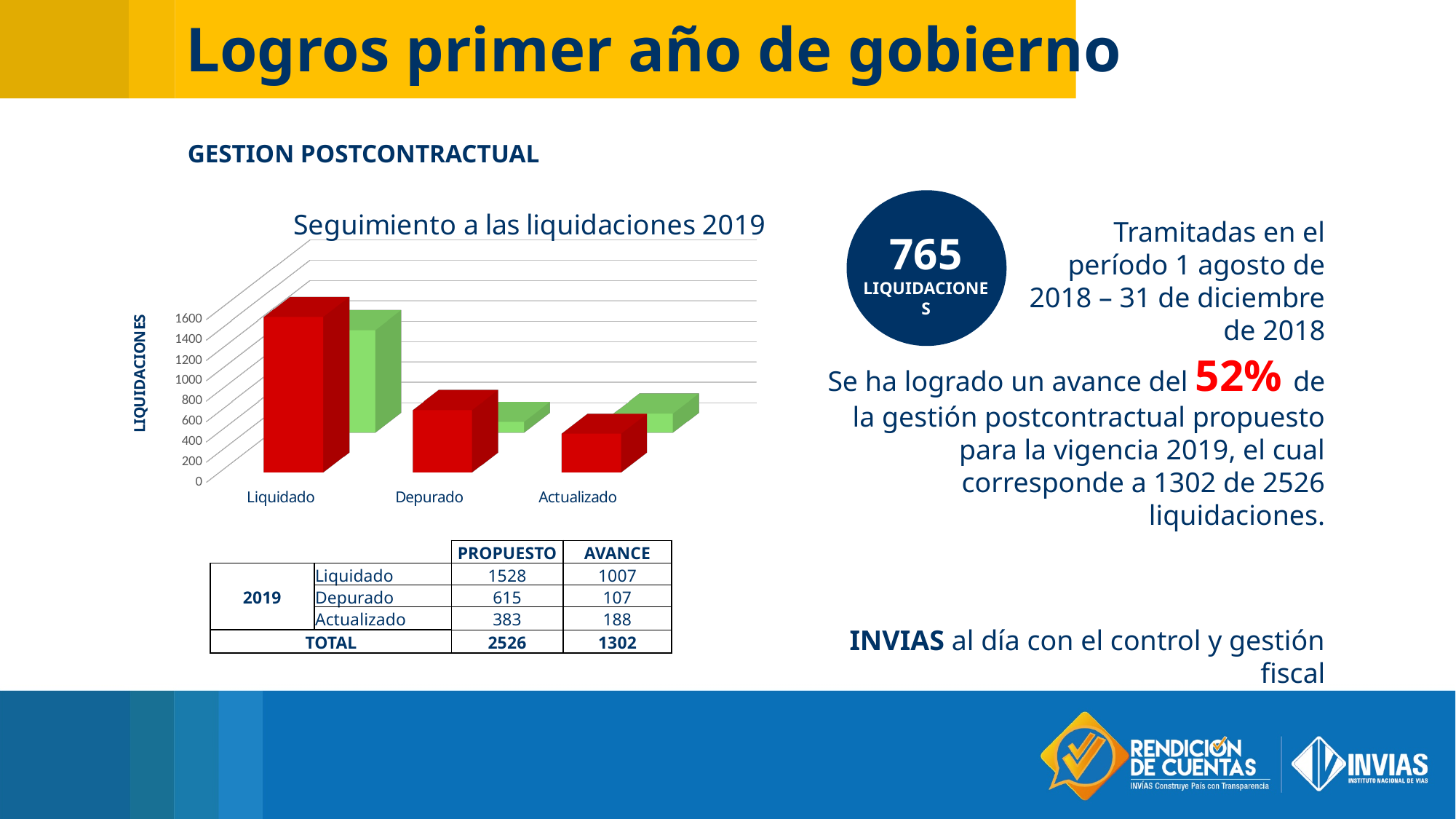
What is the title of the chart? Seguimiento a las liquidaciones 2019 What is the TOTAL of the PROPUESTO column in the table? 2526 Is the value of the red bar for Depurado greater or less than 800? less What is the label on the vertical axis of the chart? LIQUIDACIONES Which category has the shortest red bar in the chart? Actualizado Is the value of the red bar for Liquidado greater or less than 1000? greater Which category has the tallest red bar in the chart? Liquidado What is the difference between the PROPUESTO and AVANCE values for Liquidado in the table? 521 How many categories are shown on the x axis of the chart? 3 According to the table below the chart, what is the PROPUESTO value for Liquidado? 1528 According to the table below the chart, what is the AVANCE value for Depurado? 107 What kind of chart is shown on the slide? bar chart